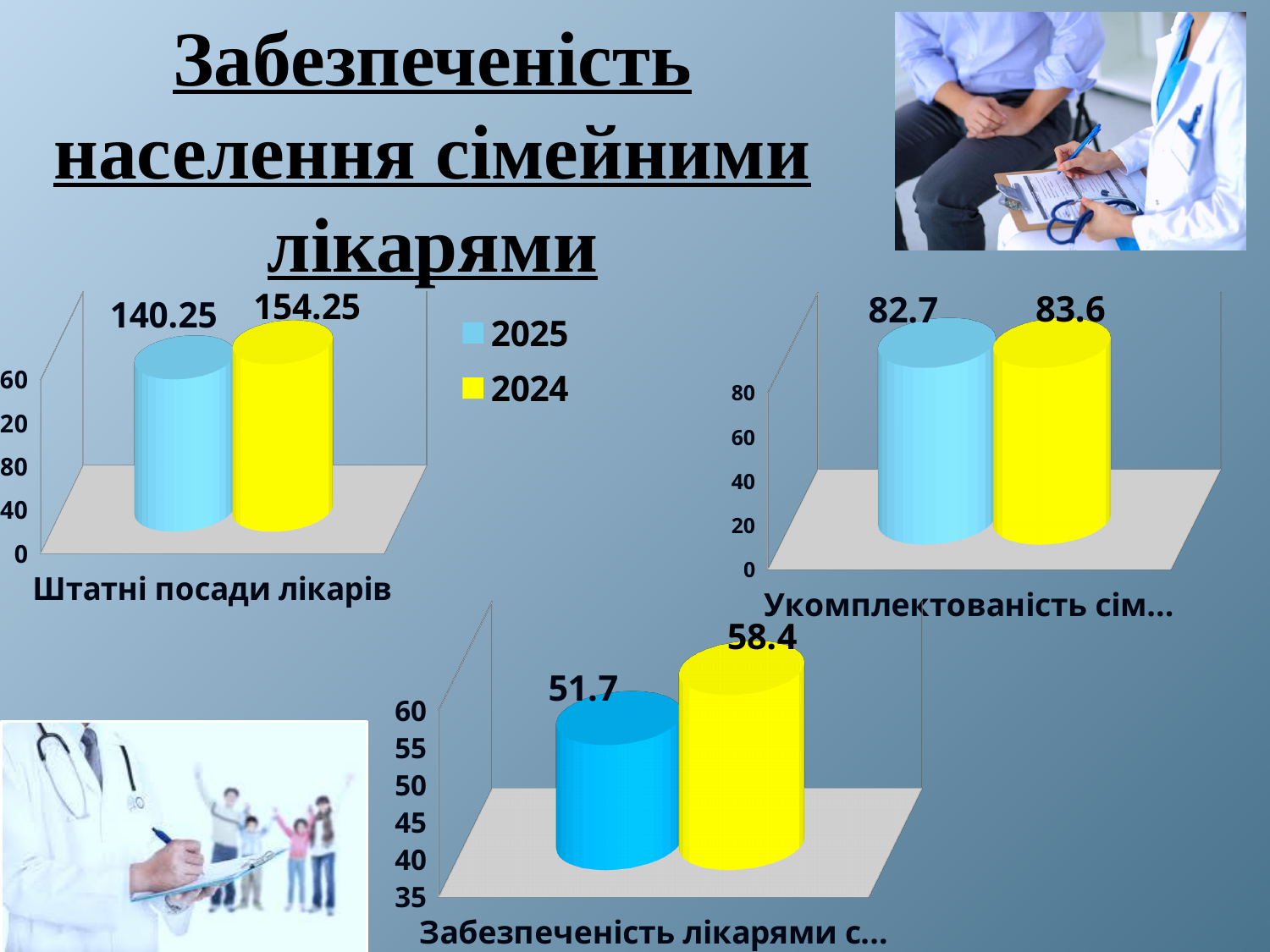
In the chart titled 'Штатні посади лікарів', which year has the larger value, 2024 or 2025? 2024 In the bottom chart (Забезпеченість лікарями с...), what is the value of the blue bar? 51.7 In the chart titled 'Штатні посади лікарів', what is the difference between the 2024 and 2025 values? 14 In the top-right chart (Укомплектованість сім...), what is the difference between the yellow and blue bar values? 0.9 In the top-right chart (Укомплектованість сім...), what is the value of the blue bar? 82.7 How many series does the legend on the slide list? 2 In the top-right chart (Укомплектованість сім...), what is the value of the yellow bar? 83.6 In the chart titled 'Штатні посади лікарів', what is the value for 2025? 140.25 In the bottom chart (Забезпеченість лікарями с...), which bar is higher, the blue or the yellow one? yellow In the bottom chart (Забезпеченість лікарями с...), what is the value of the yellow bar? 58.4 In the chart titled 'Штатні посади лікарів', what is the value for 2024? 154.25 What kind of chart is the chart titled 'Штатні посади лікарів'? bar chart